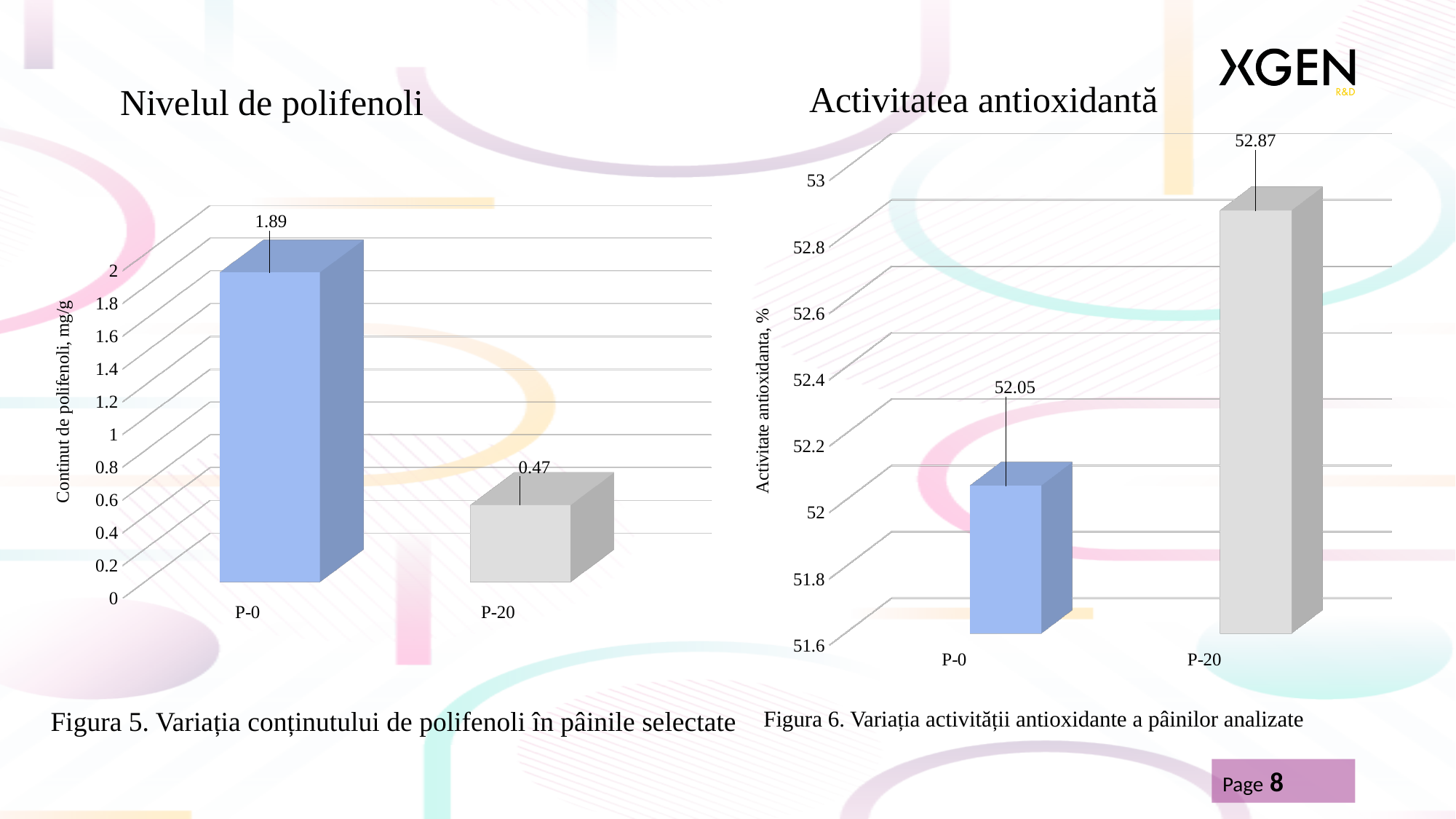
What kind of chart is the 'Nivelul de polifenoli' chart? bar chart In the 'Nivelul de polifenoli' chart, what is the difference between the values for P-0 and P-20? 1.42 In the 'Nivelul de polifenoli' chart, how many categories are shown? 2 In the 'Activitatea antioxidantă' chart, which is larger, the value for P-0 or P-20? P-20 In the 'Activitatea antioxidantă' chart, what is the value for P-0? 52.05 What is the y-axis label of the 'Activitatea antioxidantă' chart? Activitate antioxidanta, % In the 'Nivelul de polifenoli' chart, which category has the highest value? P-0 In the 'Nivelul de polifenoli' chart, what is the value for P-20? 0.47 In the 'Activitatea antioxidantă' chart, what is the value for P-20? 52.87 In the 'Activitatea antioxidantă' chart, which category has the lowest value? P-0 In the 'Activitatea antioxidantă' chart, what is the difference between the values for P-20 and P-0? 0.82 In the 'Nivelul de polifenoli' chart, what is the value for P-0? 1.89